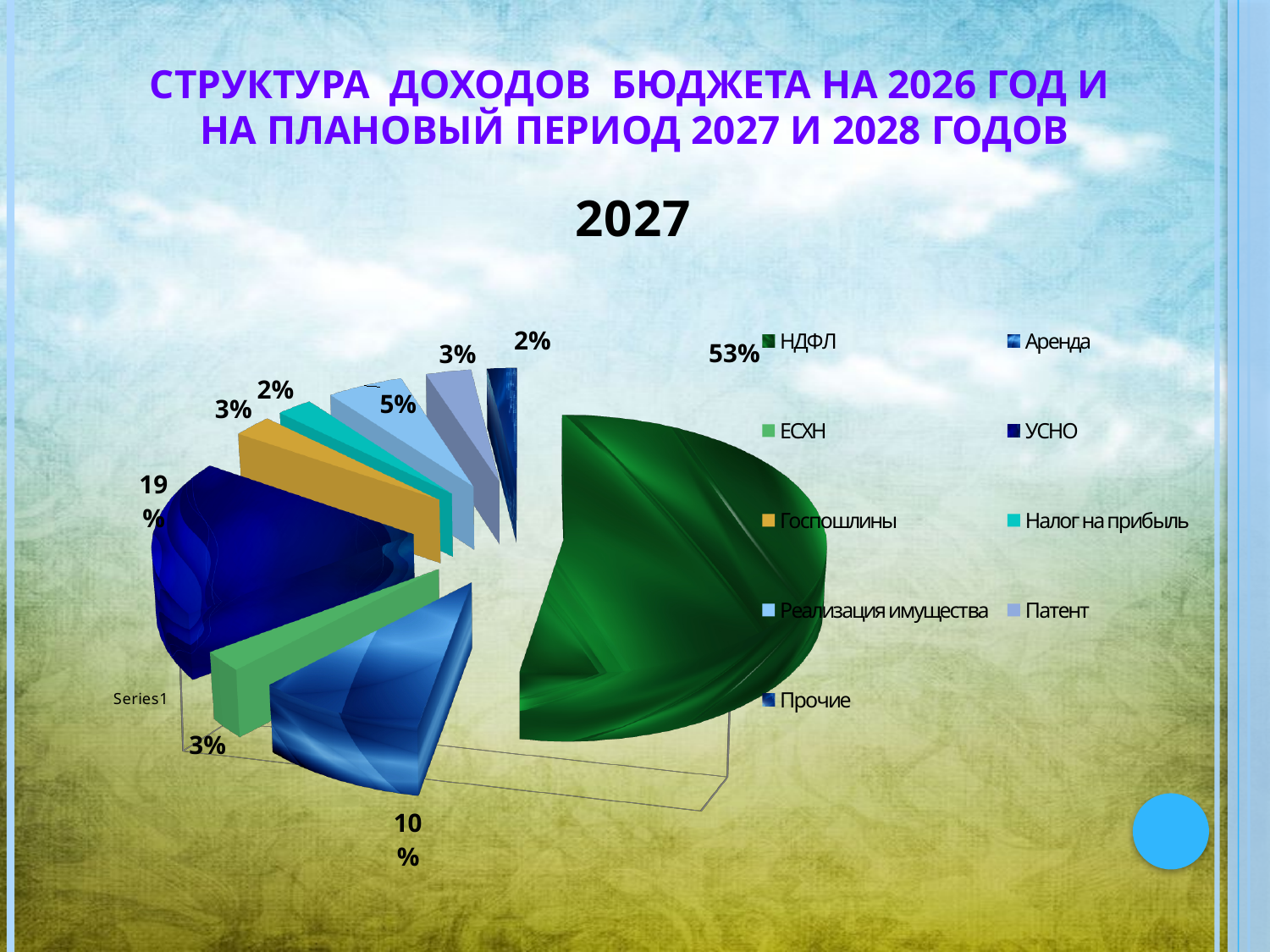
How many categories does the legend of the 2027 pie chart list? 9 What is the share for УСНО in the 2027 pie chart? 19% What kind of chart is shown on the slide? pie chart What colour is the НДФЛ slice in the 2027 pie chart? green What is the difference between the shares of НДФЛ and УСНО in the 2027 pie chart? 34% Which category has the largest share in the 2027 pie chart? НДФЛ What is the share for Реализация имущества in the 2027 pie chart? 5% What year is shown as the title of the pie chart? 2027 What is the difference between the shares of Аренда and Реализация имущества in the 2027 pie chart? 5% What is the share for НДФЛ in the 2027 pie chart? 53% What is the share for Аренда in the 2027 pie chart? 10% Which is larger in the 2027 pie chart, УСНО or Аренда? УСНО